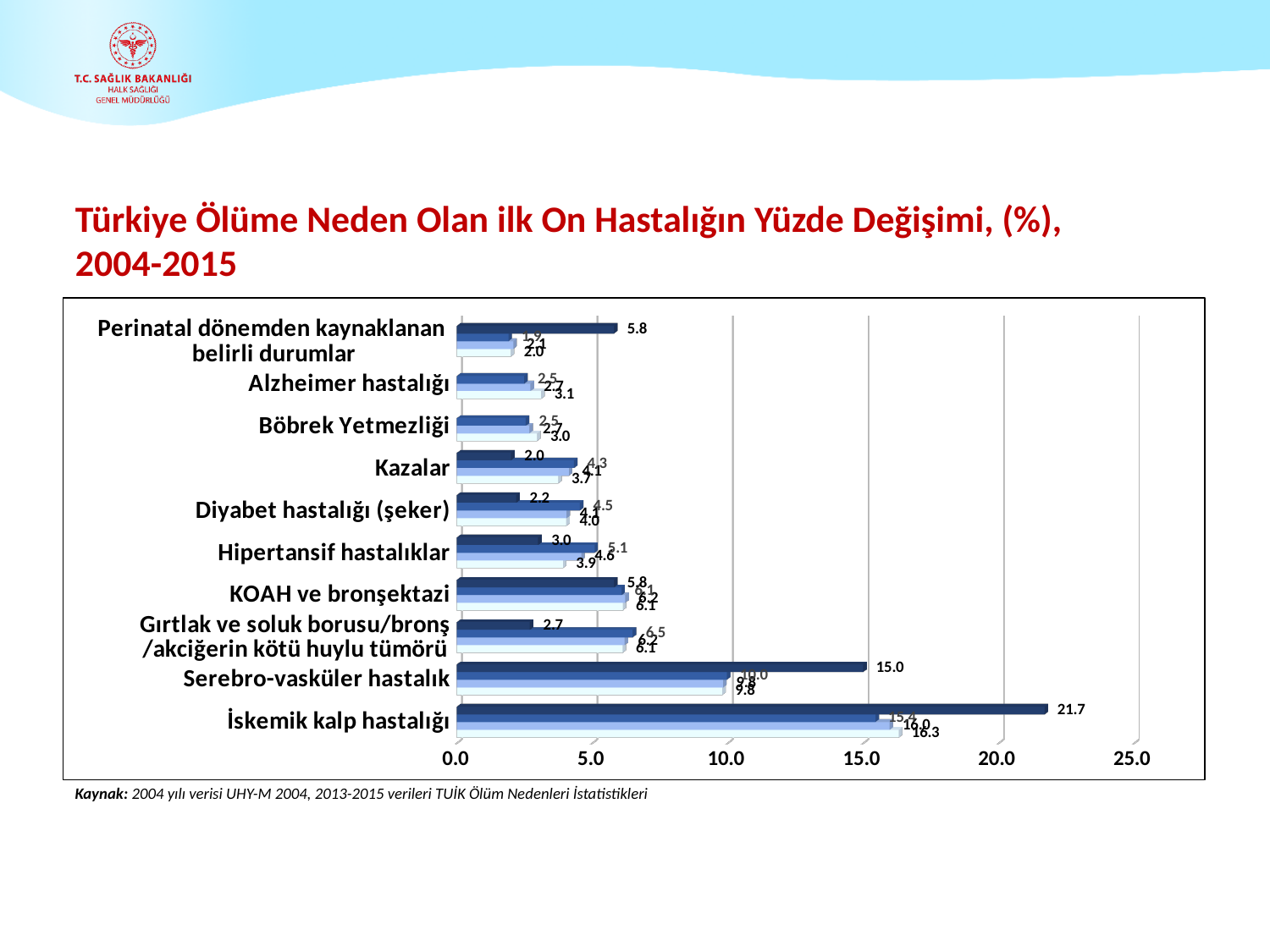
What is the maximum value shown on the horizontal axis of the chart? 25.0 What is the value of the longest (dark navy) bar for İskemik kalp hastalığı? 21.7 What kind of chart is shown on the slide? Bar chart What is the value of the dark navy (topmost) bar for Perinatal dönemden kaynaklanan belirli durumlar? 5.8 What is the value of the dark navy (topmost) bar for Serebro-vasküler hastalık? 15.0 How many disease categories are listed on the vertical axis of the chart? 10 Which disease category has the longest bar in the chart? İskemik kalp hastalığı What is the title of the chart on the slide? Türkiye Ölüme Neden Olan ilk On Hastalığın Yüzde Değişimi, (%), 2004-2015 Which has the larger dark navy (topmost) bar: Serebro-vasküler hastalık or İskemik kalp hastalığı? İskemik kalp hastalığı Is the value of the dark navy bar for Serebro-vasküler hastalık greater or less than 10.0? greater What is the difference between the dark navy bar for İskemik kalp hastalığı (21.7) and the dark navy bar for Serebro-vasküler hastalık (15.0)? 6.7